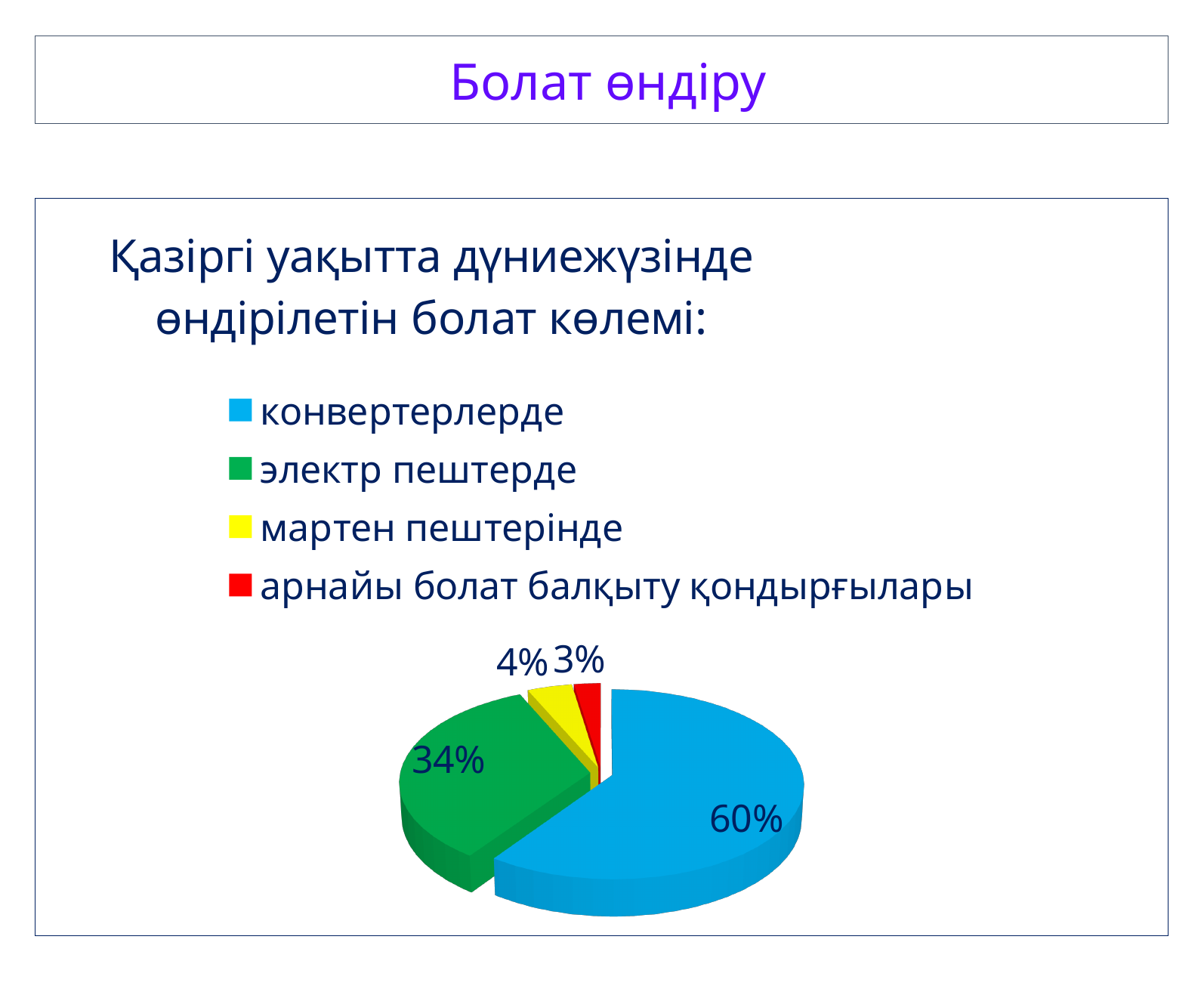
What is the difference in percentage points between конвертерлерде and электр пештерде? 26 What kind of chart is shown on the slide? pie chart What share of steel production is in электр пештерде? 34% How many categories does the pie chart have? 4 What share of steel production is in арнайы болат балқыту қондырғылары? 3% What share of steel production is in мартен пештерінде? 4% What is the title of the chart? Қазіргі уақытта дүниежүзінде өндірілетін болат көлемі: Which is larger, the share for мартен пештерінде or the share for арнайы болат балқыту қондырғылары? мартен пештерінде Which category has the largest slice of the pie? конвертерлерде What share of steel production is in конвертерлерде? 60% What colour is the slice for электр пештерде? green Which category has the smallest slice of the pie? арнайы болат балқыту қондырғылары